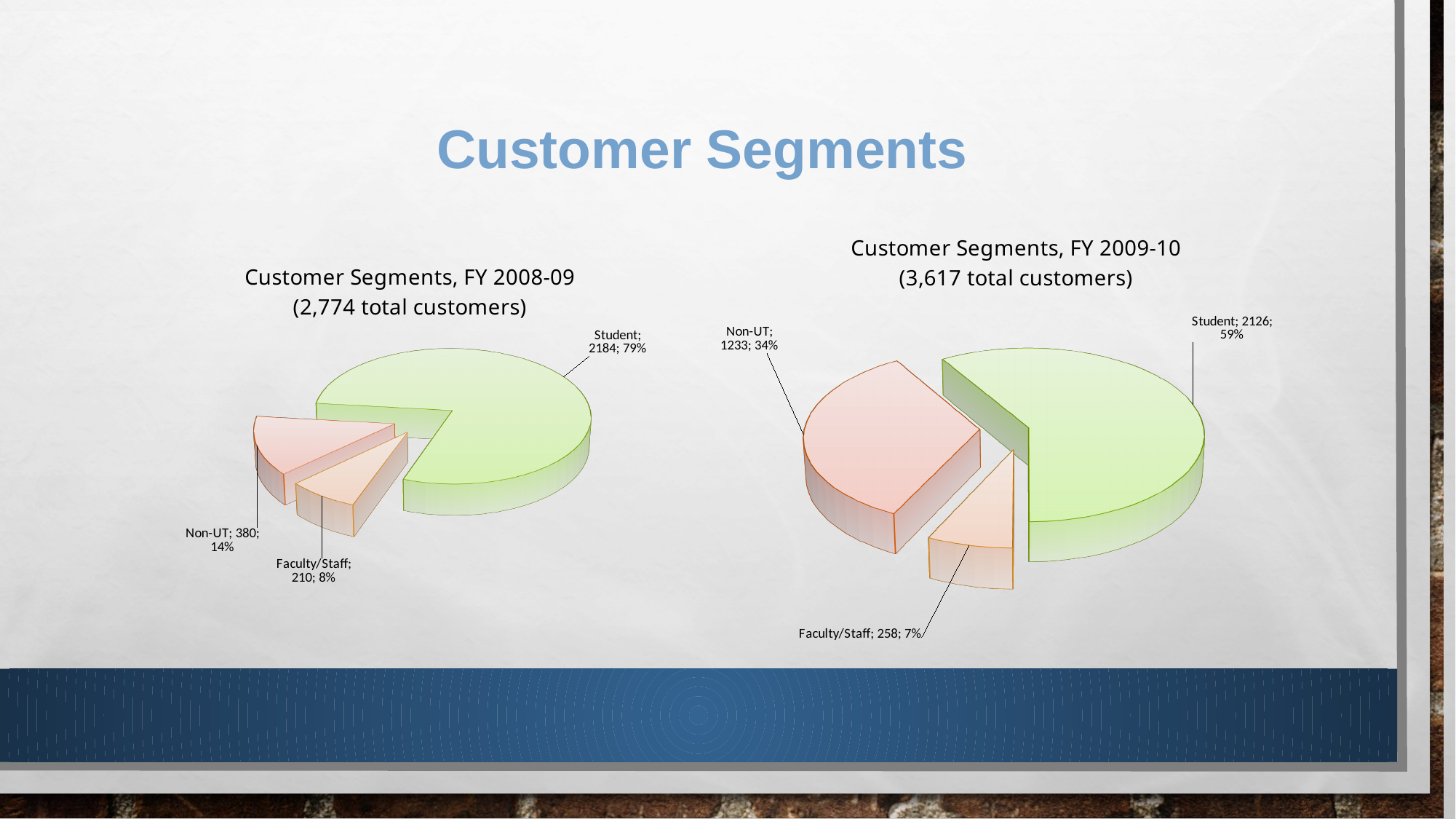
How many segments does the 'Customer Segments, FY 2009-10' chart show? 3 In the 'Customer Segments, FY 2008-09' chart, what is the difference between the Non-UT and Faculty/Staff customer counts? 170 In the 'Customer Segments, FY 2008-09' chart, what share of the pie is Non-UT? 14% In the 'Customer Segments, FY 2009-10' chart, which is larger, the Non-UT segment or the Faculty/Staff segment? Non-UT In the 'Customer Segments, FY 2009-10' chart, which segment is the smallest? Faculty/Staff In the 'Customer Segments, FY 2008-09' chart, which segment is the largest? Student In the 'Customer Segments, FY 2008-09' chart, how many customers are in the Student segment? 2184 In the 'Customer Segments, FY 2009-10' chart, what share of the pie is Faculty/Staff? 7% According to the chart title, how many total customers were there in FY 2009-10? 3,617 In the 'Customer Segments, FY 2009-10' chart, how many customers are in the Non-UT segment? 1233 In the 'Customer Segments, FY 2009-10' chart, what share of the pie is Student? 59% What kind of chart is the 'Customer Segments, FY 2008-09' chart? Pie chart